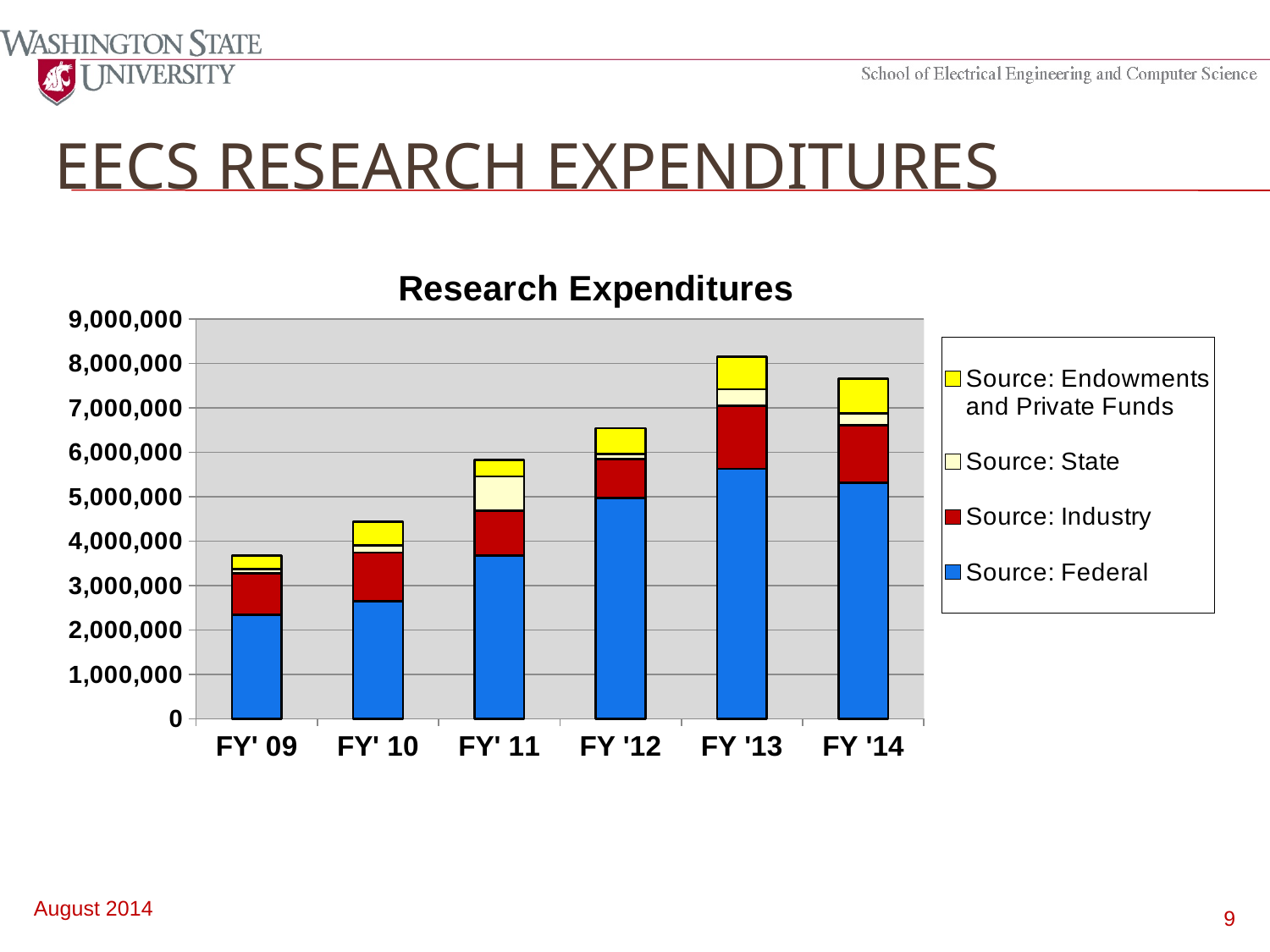
How many series does the chart's legend list? 4 Is the Source: Federal value for FY '12 greater or less than 4,000,000? greater Which fiscal year has the highest total research expenditures? FY '13 Which has the larger total research expenditure, FY '13 or FY '14? FY '13 How many fiscal years are shown on the x axis of the chart? 6 What is the title of the chart? Research Expenditures Is the total research expenditure for FY' 09 greater or less than 4,000,000? less Which colour represents Source: Federal in the chart? Blue Do total research expenditures rise or fall from FY' 09 to FY '13? rise Is the total research expenditure for FY '13 greater or less than 7,000,000? greater Which fiscal year has the lowest total research expenditures? FY' 09 What kind of chart is shown on the slide? Stacked bar chart